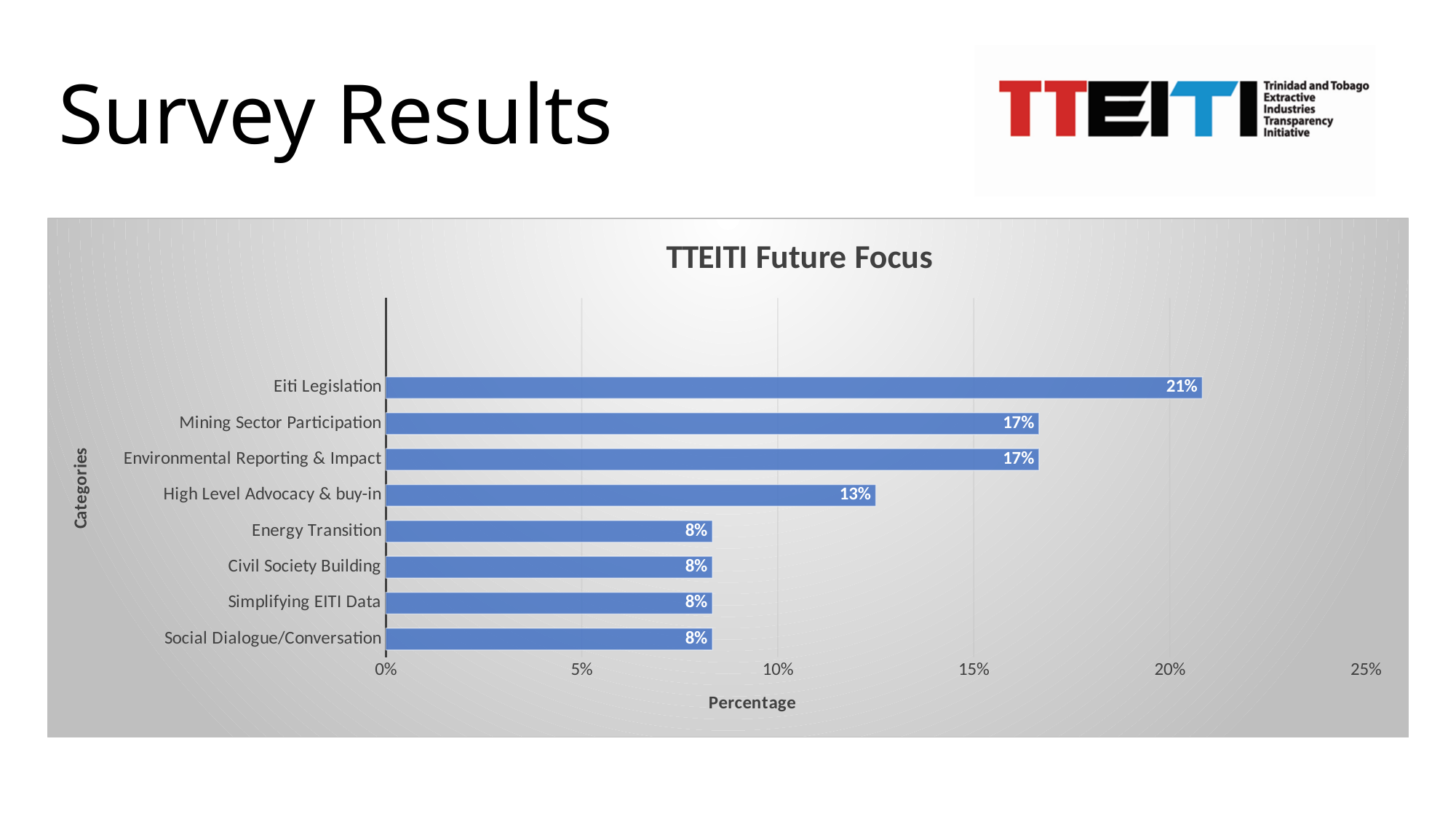
Which category has the highest value? Eiti Legislation What is the difference between the values for Eiti Legislation and High Level Advocacy & buy-in? 8% What is the label of the horizontal axis? Percentage What is the value for Eiti Legislation? 21% What is the value for High Level Advocacy & buy-in? 13% What kind of chart is shown on the slide? Bar chart Which is larger, the value for Mining Sector Participation or the value for Civil Society Building? Mining Sector Participation What is the title of the chart? TTEITI Future Focus Is the value for Environmental Reporting & Impact greater or less than 15%? greater How many categories are shown in the chart? 8 What is the value for Mining Sector Participation? 17% What is the value for Energy Transition? 8%